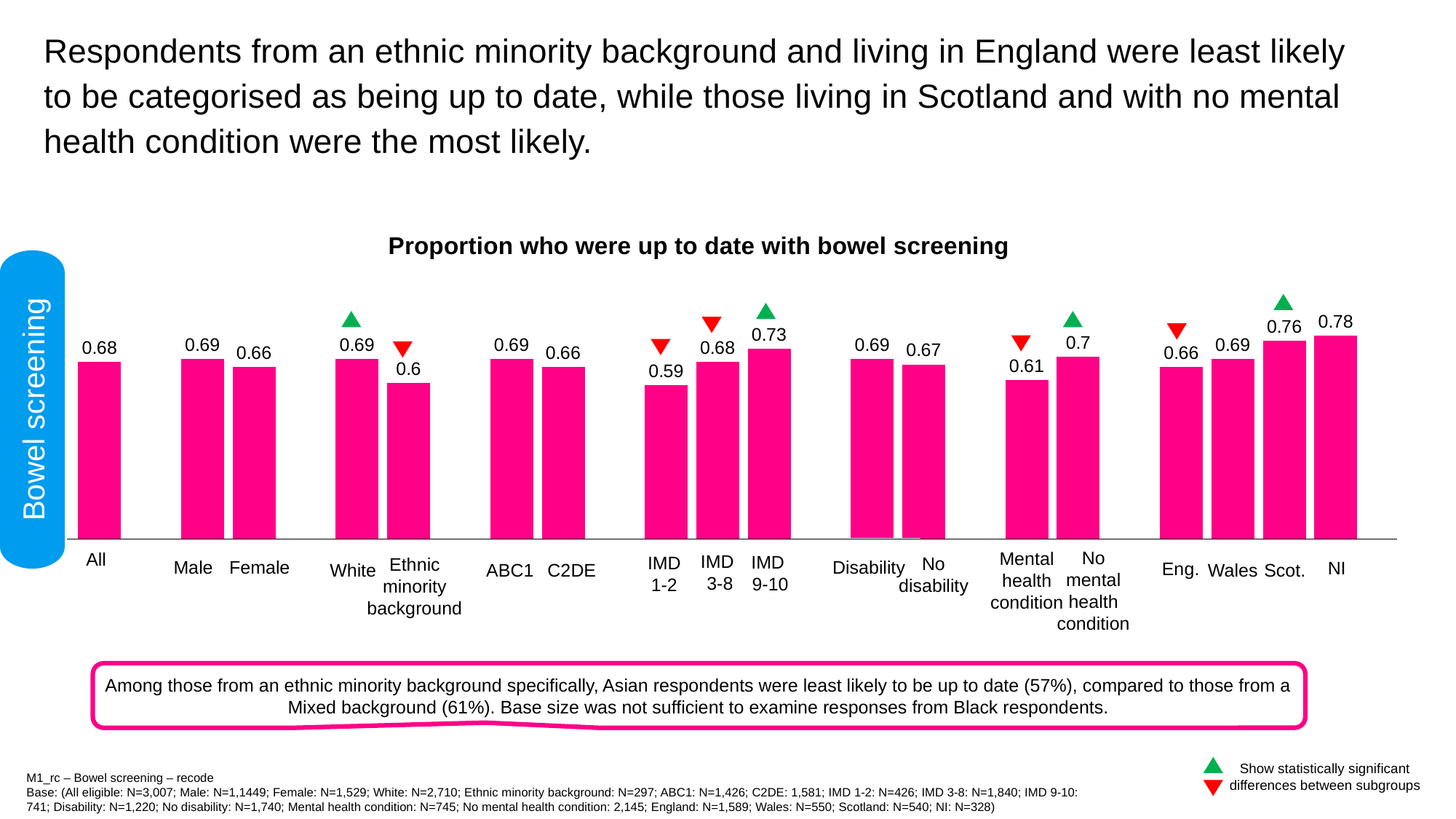
What is the value for IMD 9-10? 0.73 What kind of chart is shown on the slide? Bar chart What is the title of the chart? Proportion who were up to date with bowel screening Which is larger, the value for White or the value for Ethnic minority background? White What is the value for Scot.? 0.76 What is the value for Ethnic minority background? 0.6 What is the value for Mental health condition? 0.61 Which category has the highest value? NI What is the difference between the values for No mental health condition and Mental health condition? 0.09 What is the difference between the values for Scot. and Eng.? 0.1 Which category has the lowest value? IMD 1-2 How many bars are plotted in the chart? 18